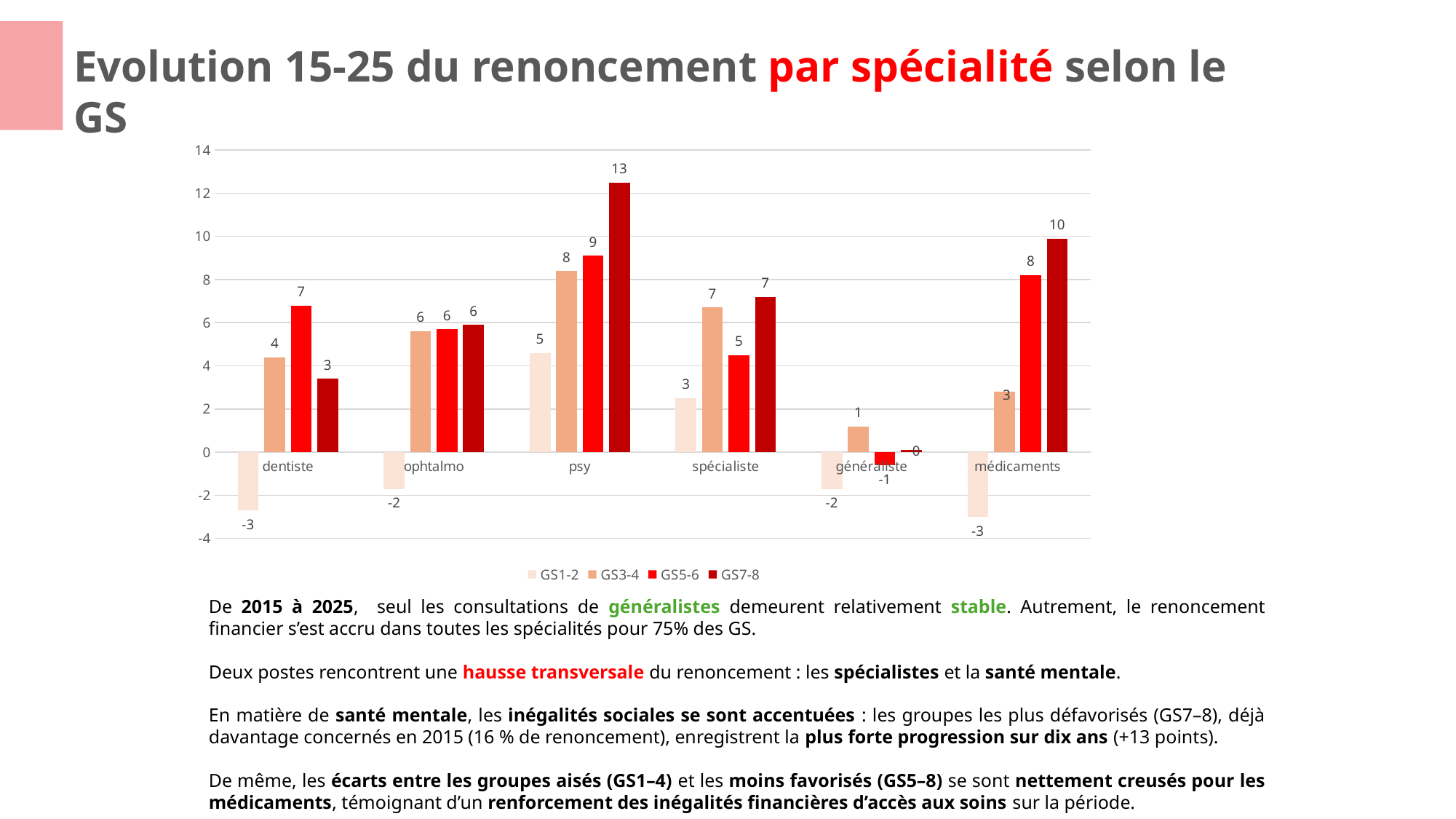
What is the difference between the GS7-8 and GS1-2 values in the médicaments category? 13 Which category has the lowest GS5-6 value? généraliste Is the GS7-8 value for psy greater or less than 12? greater Which category has the highest GS7-8 value? psy Which series is shown in the darkest red colour in the legend? GS7-8 What is the value for GS5-6 in the généraliste category? -1 What is the value for GS1-2 in the médicaments category? -3 How many specialty categories are shown on the x axis? 6 What is the value for GS7-8 in the psy category? 13 In the dentiste category, which is larger: the GS5-6 value or the GS7-8 value? GS5-6 How many series does the legend list? 4 What type of chart is shown on the slide? bar chart